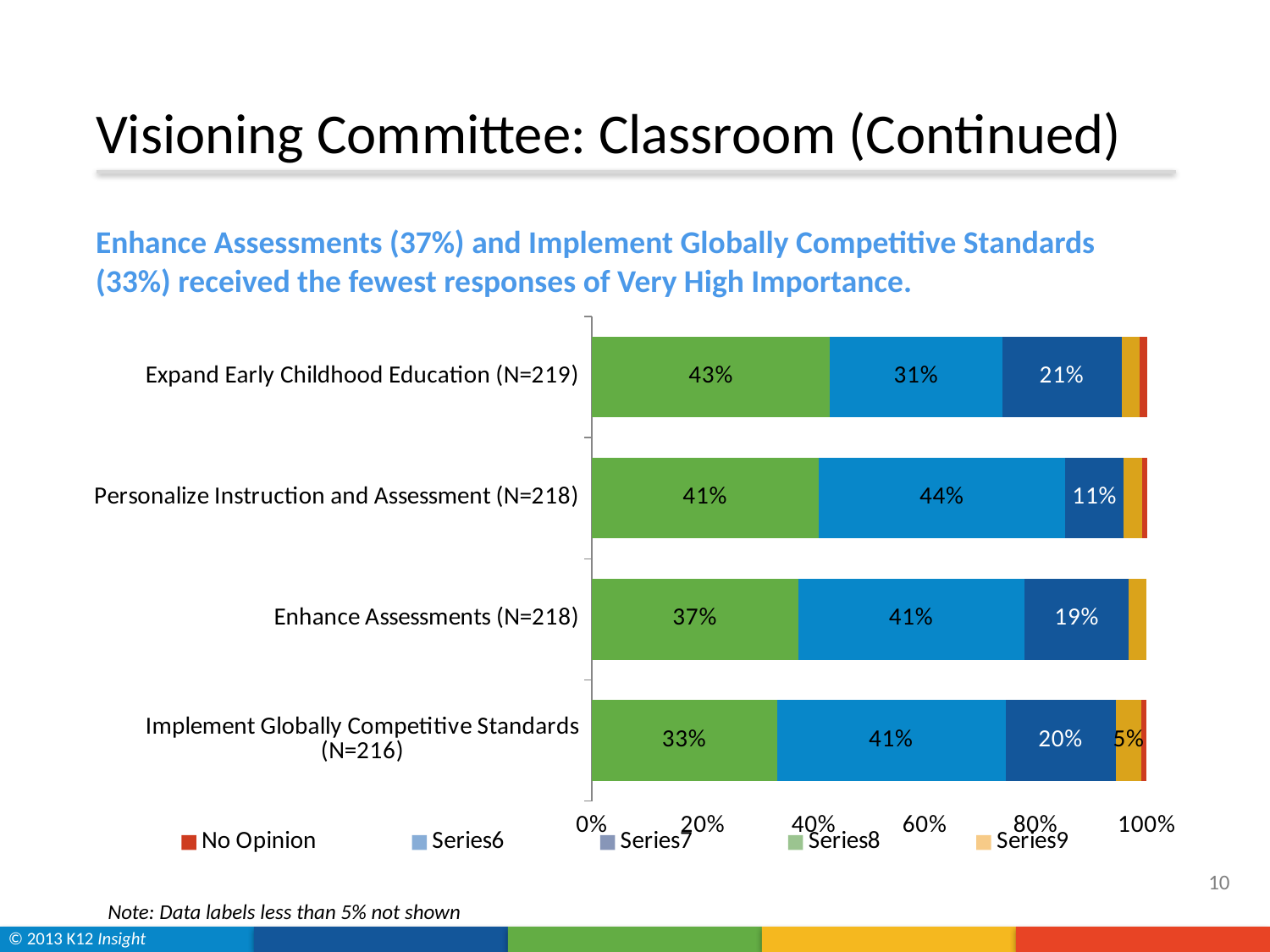
Which category has the smallest green segment? Implement Globally Competitive Standards (N=216) What is the value of the green segment for Expand Early Childhood Education (N=219)? 43% What is the value of the dark blue segment for Enhance Assessments (N=218)? 19% What is the value of the orange segment for Implement Globally Competitive Standards (N=216)? 5% According to the note below the chart, which data labels are not shown? Data labels less than 5% How many series does the chart legend list? 5 What kind of chart is shown on the slide? Bar chart Which category has the largest green segment? Expand Early Childhood Education (N=219) What is the value of the light blue segment for Personalize Instruction and Assessment (N=218)? 44% What is the difference between the green segment for Expand Early Childhood Education (43%) and the green segment for Implement Globally Competitive Standards (33%)? 10 percentage points Which has the larger dark blue segment: Expand Early Childhood Education or Personalize Instruction and Assessment? Expand Early Childhood Education How many categories (bars) are plotted in the chart? 4